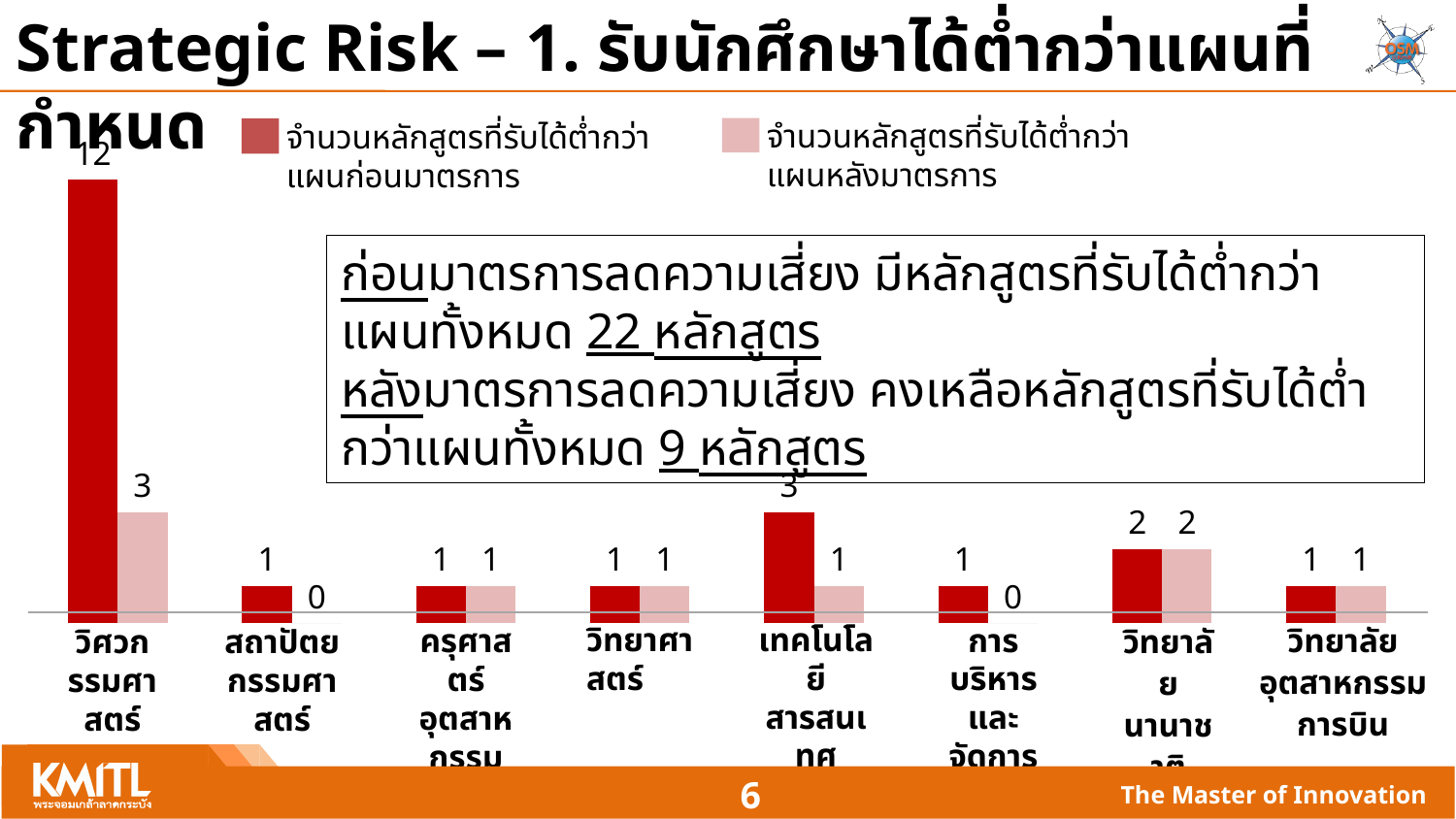
What is the value for วิศวกรรมศาสตร์ in the series จำนวนหลักสูตรที่รับได้ต่ำกว่าแผนหลังมาตรการ? 3 What is the value for วิศวกรรมศาสตร์ in the series จำนวนหลักสูตรที่รับได้ต่ำกว่าแผนก่อนมาตรการ? 12 Which is larger for เทคโนโลยีสารสนเทศ: the value before measures (ก่อนมาตรการ) or after measures (หลังมาตรการ)? before measures (ก่อนมาตรการ) What is the value for สถาปัตยกรรมศาสตร์ in the series จำนวนหลักสูตรที่รับได้ต่ำกว่าแผนหลังมาตรการ? 0 How many faculty categories are shown on the x axis of the chart? 8 Which colour represents the series จำนวนหลักสูตรที่รับได้ต่ำกว่าแผนหลังมาตรการ in the chart? light pink What is the value for เทคโนโลยีสารสนเทศ in the series จำนวนหลักสูตรที่รับได้ต่ำกว่าแผนก่อนมาตรการ? 3 What is the difference between the before-measures and after-measures values for เทคโนโลยีสารสนเทศ? 2 What type of chart is shown on the slide? bar chart How many series does the chart legend list? 2 What is the difference between the before-measures and after-measures values for วิศวกรรมศาสตร์? 9 Which category has the highest value in the series จำนวนหลักสูตรที่รับได้ต่ำกว่าแผนก่อนมาตรการ? วิศวกรรมศาสตร์